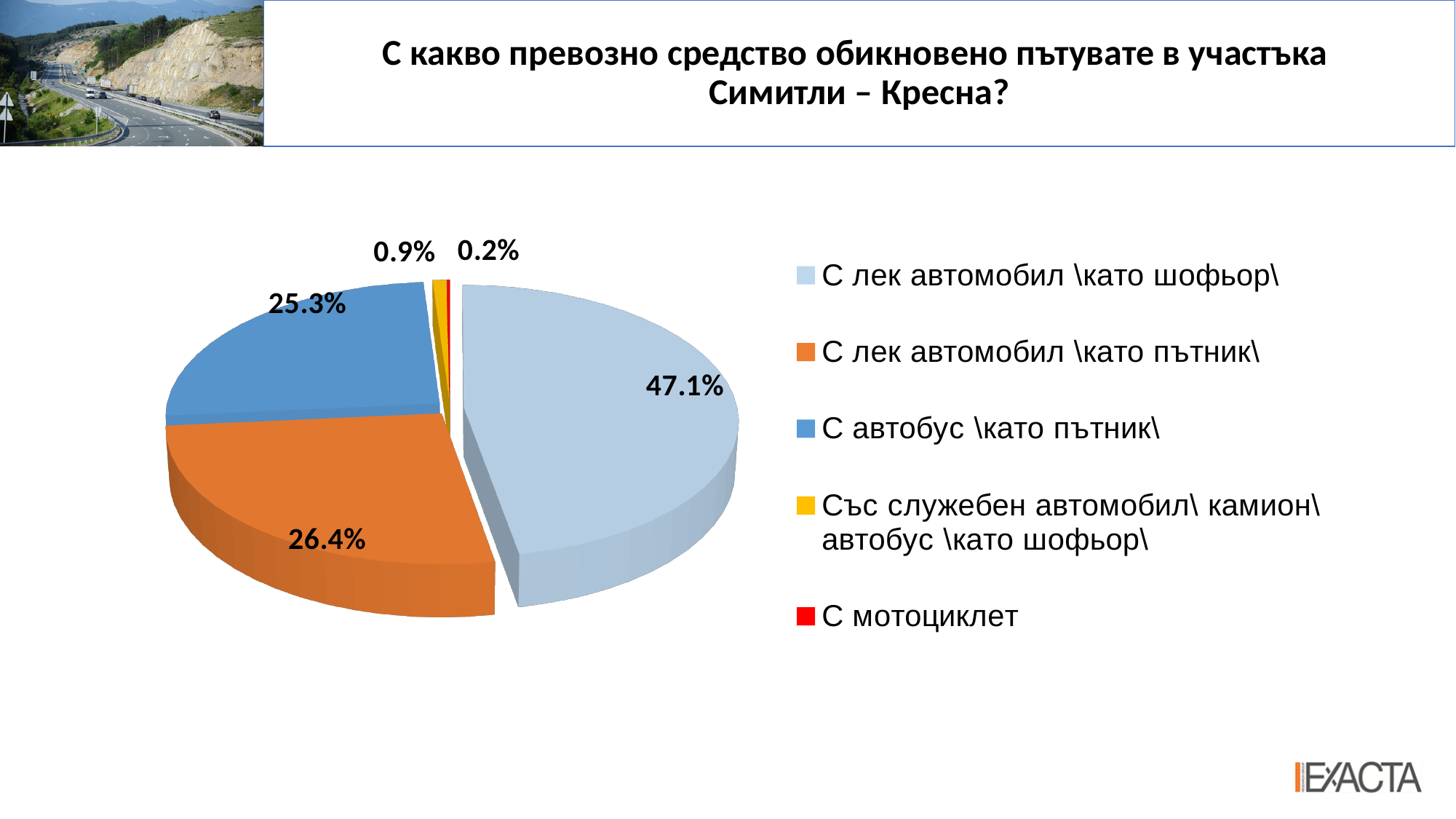
How many categories does the pie chart show? 5 What share of the pie does "С автобус \като пътник\" have? 25.3% Which is larger: the share for "С лек автомобил \като пътник\" or the share for "С автобус \като пътник\"? С лек автомобил \като пътник\ What is the difference between the shares for "С лек автомобил \като шофьор\" and "С лек автомобил \като пътник\"? 20.7% What share of the pie does "С лек автомобил \като шофьор\" have? 47.1% Which category has the largest slice of the pie? С лек автомобил \като шофьор\ What share of the pie does "Със служебен автомобил\ камион\ автобус \като шофьор\" have? 0.9% What share of the pie does "С мотоциклет" have? 0.2% What colour is the slice for "С автобус \като пътник\"? Blue Which category has the smallest slice of the pie? С мотоциклет What kind of chart is shown on the slide? Pie chart What share of the pie does "С лек автомобил \като пътник\" have? 26.4%